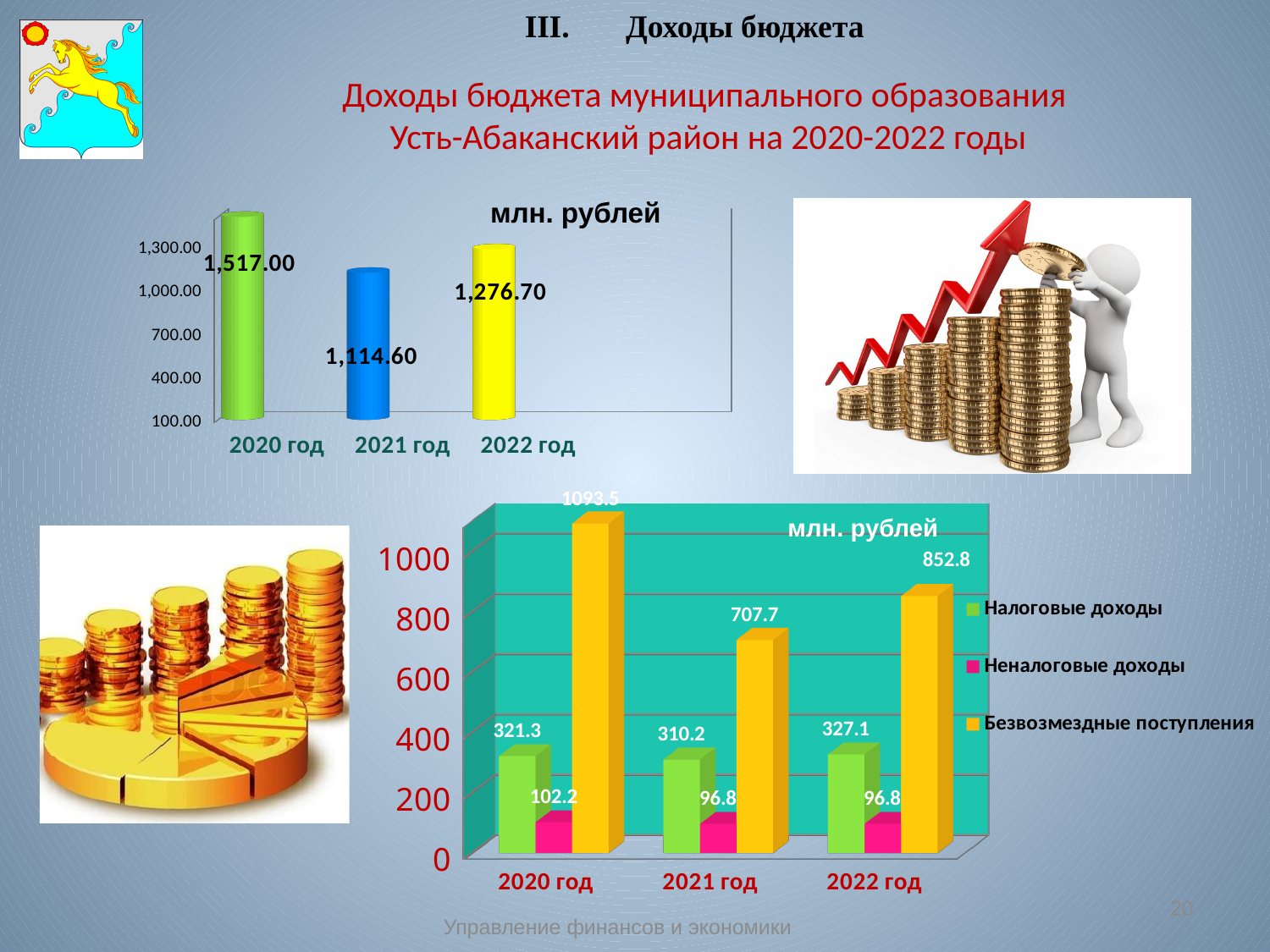
In the top-left chart, what is the value for 2020 год? 1,517.00 In the top-left chart, how many bars are plotted? 3 In the bottom chart, how many series does the legend list? 3 In the top-left chart, what is the difference between the values for 2020 год and 2022 год? 240.30 In the bottom chart, what is the value of Безвозмездные поступления for 2021 год? 707.7 In the bottom chart, what is the value of Налоговые доходы for 2022 год? 327.1 In the top-left chart, what is the value for 2021 год? 1,114.60 In the top-left chart, which year has the lowest value? 2021 год What type of chart is the bottom chart? bar chart In the bottom chart, which year has the highest value of Безвозмездные поступления? 2020 год In the bottom chart, is the value of Налоговые доходы for 2021 год larger or smaller than the value of Неналоговые доходы for 2021 год? larger In the bottom chart, what is the value of Неналоговые доходы for 2020 год? 102.2